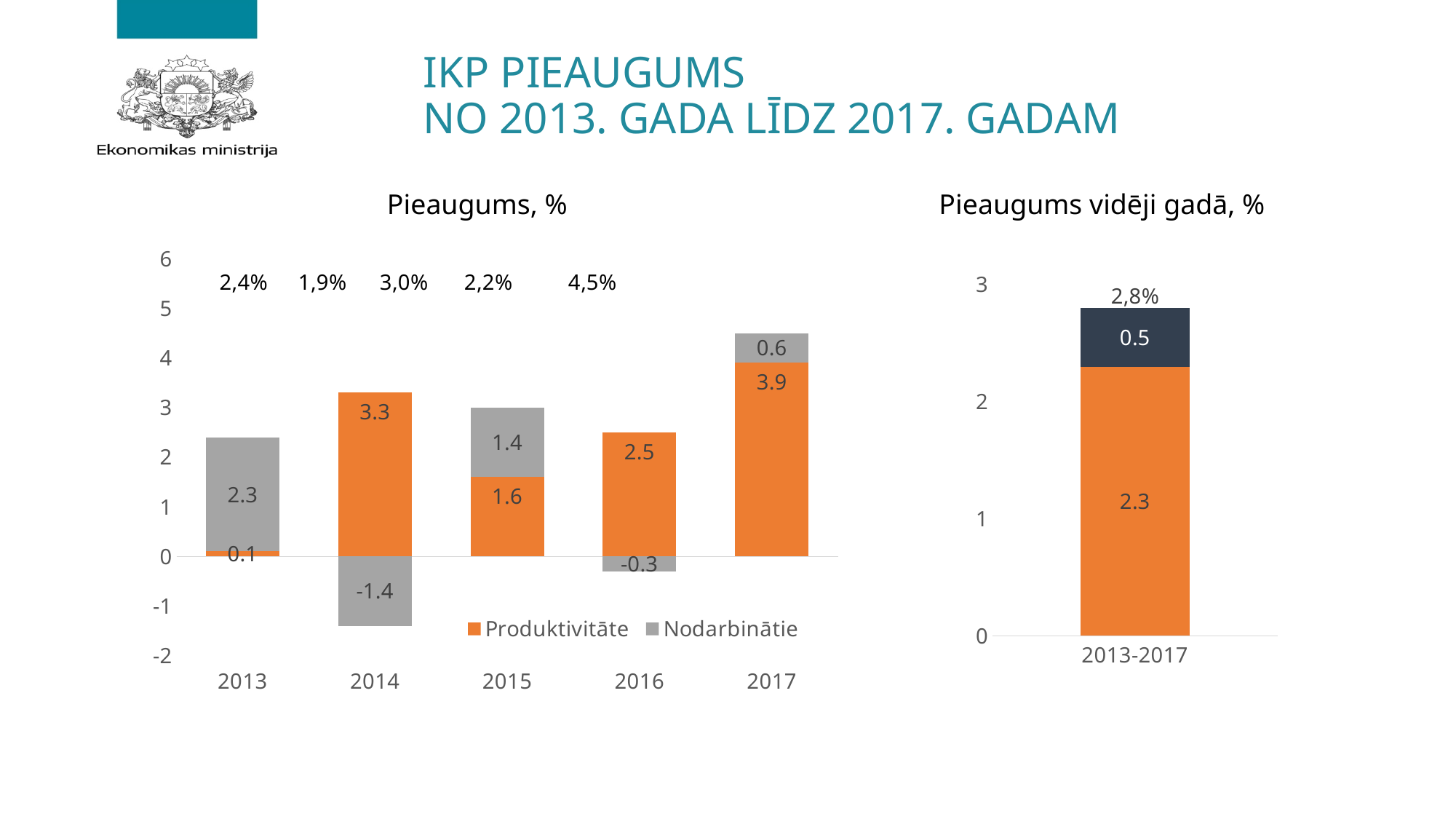
In the 'Pieaugums, %' chart, what is the Nodarbinātie value for 2014? -1.4 In the 'Pieaugums, %' chart, which year has the highest Produktivitāte value? 2017 In the 'Pieaugums, %' chart, which is larger: the Nodarbinātie value for 2013 or for 2017? 2013 How many years are shown on the x axis of the 'Pieaugums, %' chart? 5 In the 'Pieaugums, %' chart, what is the difference between the Produktivitāte values for 2017 and 2016? 1.4 In the 'Pieaugums, %' chart, what is the Nodarbinātie value for 2015? 1.4 In the 'Pieaugums, %' chart, what is the Produktivitāte value for 2014? 3.3 How many series does the legend of the 'Pieaugums, %' chart list? 2 In the 'Pieaugums vidēji gadā, %' chart, what is the total printed above the 2013-2017 bar? 2,8% In the 'Pieaugums, %' chart, which year has the lowest Produktivitāte value? 2013 What kind of chart is the 'Pieaugums vidēji gadā, %' chart? Stacked bar chart In the 'Pieaugums, %' chart, what total growth is printed above the 2017 bar? 4,5%